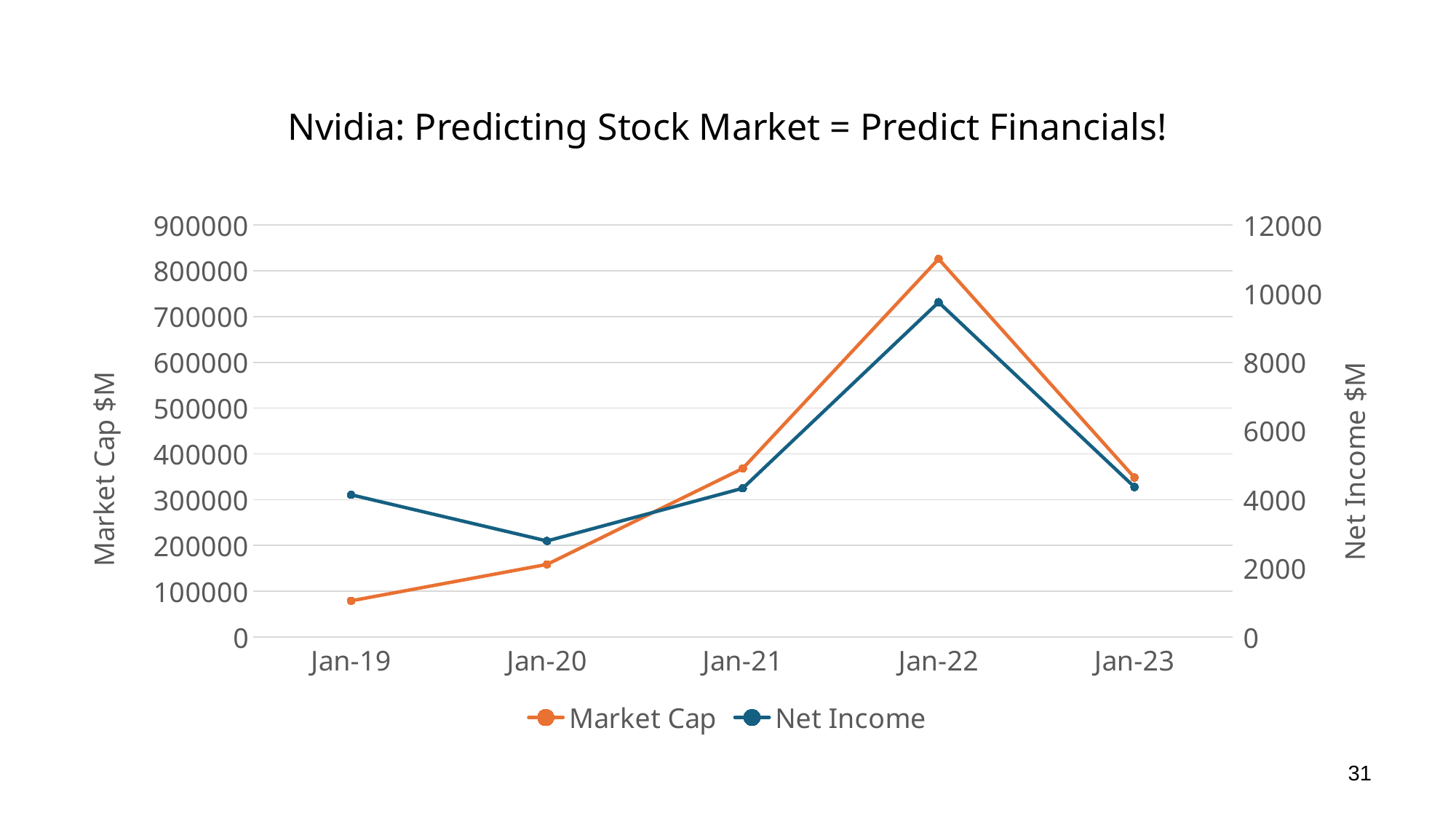
Is the Net Income value for Jan-20 greater or less than 4000? less How many dates are plotted along the x axis? 5 Which is larger, Market Cap at Jan-20 or Market Cap at Jan-21? Jan-21 What kind of chart is shown on the slide? line chart At which date is Net Income highest? Jan-22 Is the Market Cap value for Jan-19 greater or less than 100000? less At which date is Net Income lowest? Jan-20 At which date is Market Cap lowest? Jan-19 How many series does the legend list? 2 Is the Market Cap value for Jan-22 greater or less than 800000? greater What is the title of the right-hand vertical axis? Net Income $M At which date is Market Cap highest? Jan-22